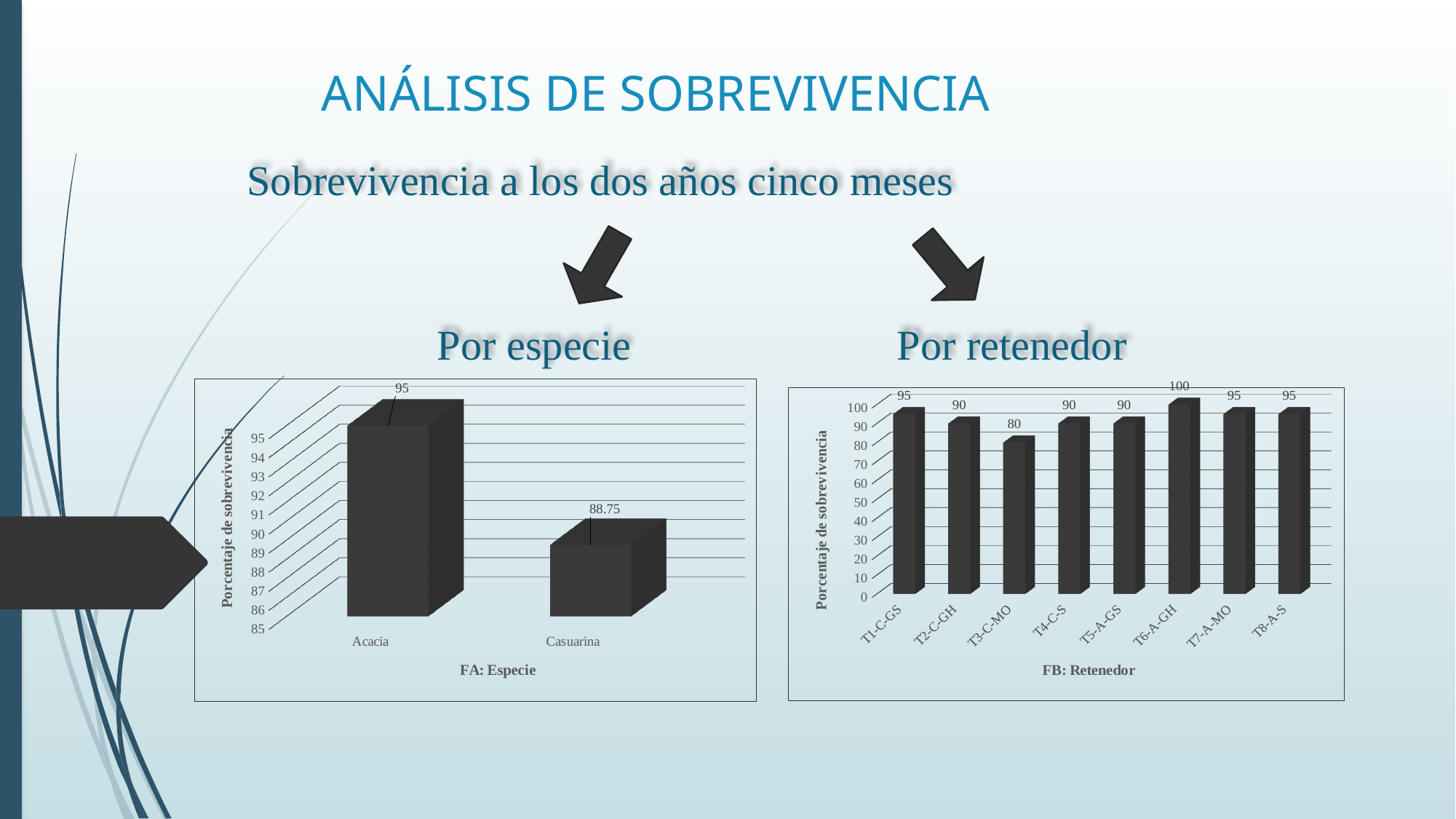
In the 'Por retenedor' chart on the right, what is the difference between the values for T6-A-GH and T3-C-MO? 20 In the 'Por especie' chart on the left, which species has the higher survival percentage? Acacia In the 'Por especie' chart on the left, what is the value for Acacia? 95 What kind of chart is the 'Por retenedor' chart on the right? Bar chart In the 'Por retenedor' chart on the right, what is the value for T6-A-GH? 100 In the 'Por retenedor' chart on the right, what is the value for T3-C-MO? 80 In the 'Por especie' chart on the left, what is the difference between the values for Acacia and Casuarina? 6.25 In the 'Por retenedor' chart on the right, which category has the highest value? T6-A-GH In the 'Por retenedor' chart on the right, which category has the lowest value? T3-C-MO In the 'Por especie' chart on the left, what is the value for Casuarina? 88.75 In the 'Por especie' chart on the left, how many categories are plotted? 2 In the 'Por retenedor' chart on the right, how many categories are plotted? 8